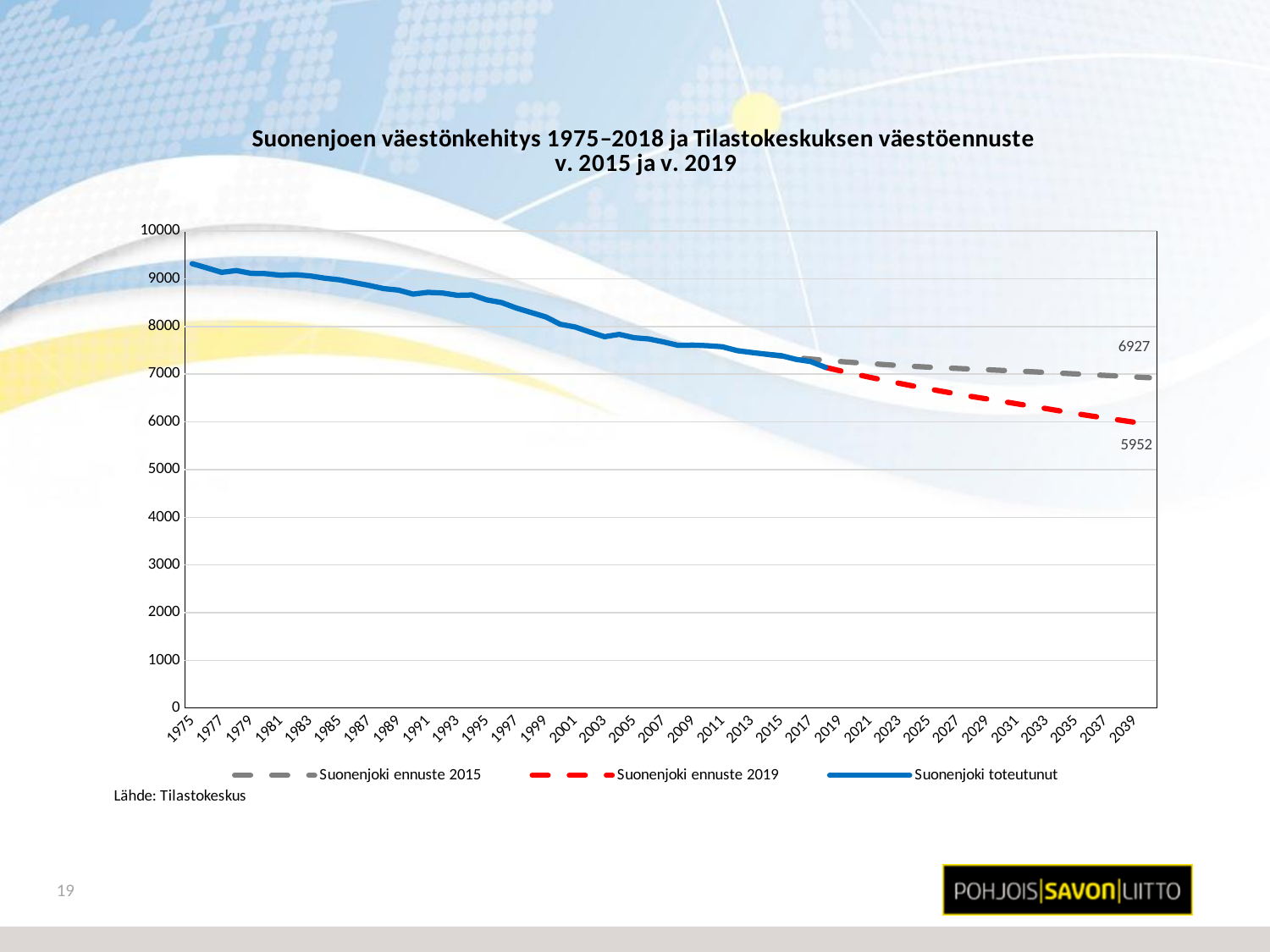
Which forecast series ends at a higher value, Suonenjoki ennuste 2015 or Suonenjoki ennuste 2019? Suonenjoki ennuste 2015 What is the final labelled value of the Suonenjoki ennuste 2019 series? 5952 Does the Suonenjoki toteutunut series rise or fall from 1975 to 2018? fall Is the value of Suonenjoki toteutunut in 1975 greater or less than 9000? greater What kind of chart is shown on the slide? line chart What colour is the Suonenjoki toteutunut line? blue Is the value of Suonenjoki toteutunut in 2017 greater or less than 8000? less What is the difference between the final labelled values of the 2015 forecast (6927) and the 2019 forecast (5952)? 975 How many series does the legend list? 3 What is the title of the chart? Suonenjoen väestönkehitys 1975–2018 ja Tilastokeskuksen väestöennuste v. 2015 ja v. 2019 Is the value of Suonenjoki ennuste 2019 in 2035 greater or less than 6500? less What is the final labelled value of the Suonenjoki ennuste 2015 series? 6927